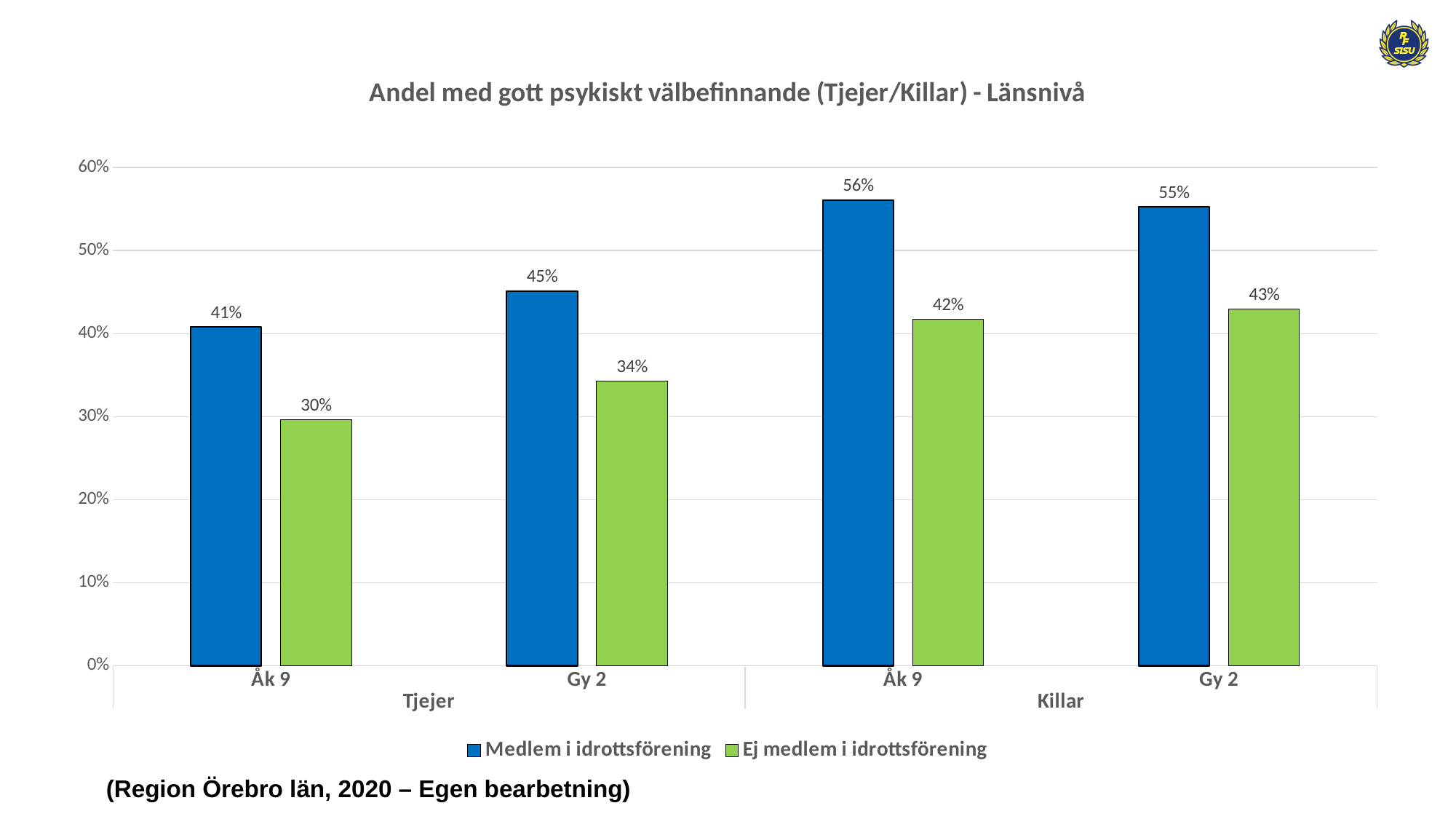
Is the value for Medlem i idrottsförening for Killar Gy 2 greater or less than 50%? greater What is the difference between Medlem i idrottsförening and Ej medlem i idrottsförening for Killar Åk 9? 14% Which group has the highest value for Medlem i idrottsförening? Killar Åk 9 What is the difference between Medlem i idrottsförening for Tjejer Gy 2 and Tjejer Åk 9? 4% How many series does the legend list? 2 Which group has the lowest value for Ej medlem i idrottsförening? Tjejer Åk 9 What kind of chart is shown on the slide? Bar chart What is the value for Ej medlem i idrottsförening for Killar Gy 2? 43% What is the value for Ej medlem i idrottsförening for Tjejer Gy 2? 34% Which is larger: Ej medlem i idrottsförening for Killar Åk 9 or Medlem i idrottsförening for Tjejer Åk 9? Ej medlem i idrottsförening for Killar Åk 9 What is the value for Medlem i idrottsförening for Tjejer Åk 9? 41% What is the title of the chart? Andel med gott psykiskt välbefinnande (Tjejer/Killar) - Länsnivå